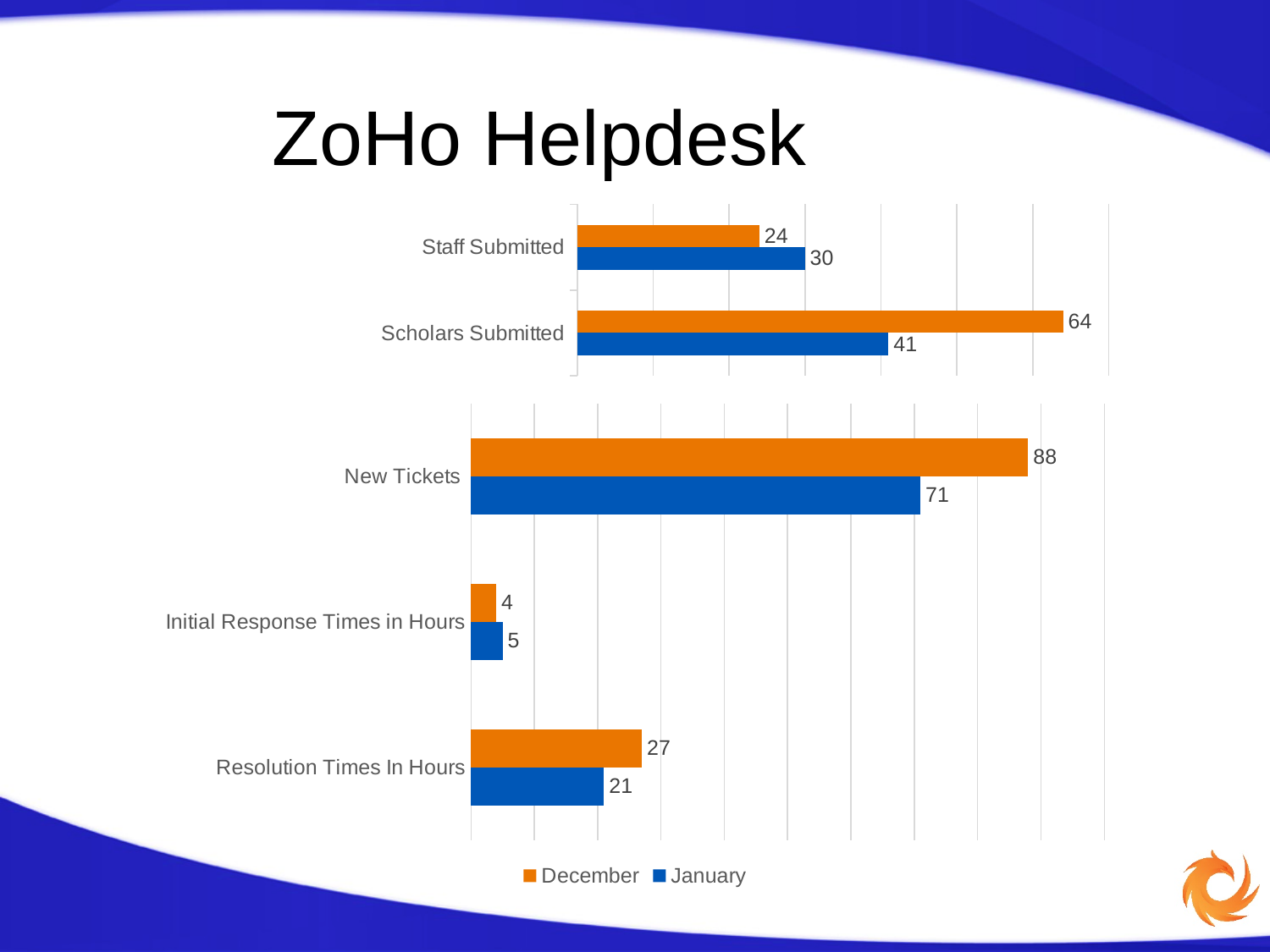
In the top chart, what is the January value for Staff Submitted? 30 How many series does the legend list? 2 In the top chart, what is the difference between the December and January values for Scholars Submitted? 23 In the top chart, which is larger for Staff Submitted, December or January? January In the bottom chart, which category has the highest December value? New Tickets In the bottom chart, what is the difference between the December and January values for New Tickets? 17 In the bottom chart, which is larger for Initial Response Times in Hours, December or January? January In the bottom chart, which category has the lowest January value? Initial Response Times in Hours In the top chart, what is the December value for Scholars Submitted? 64 In the bottom chart, what is the December value for New Tickets? 88 How many categories does the bottom chart show? 3 In the bottom chart, what is the January value for Resolution Times In Hours? 21